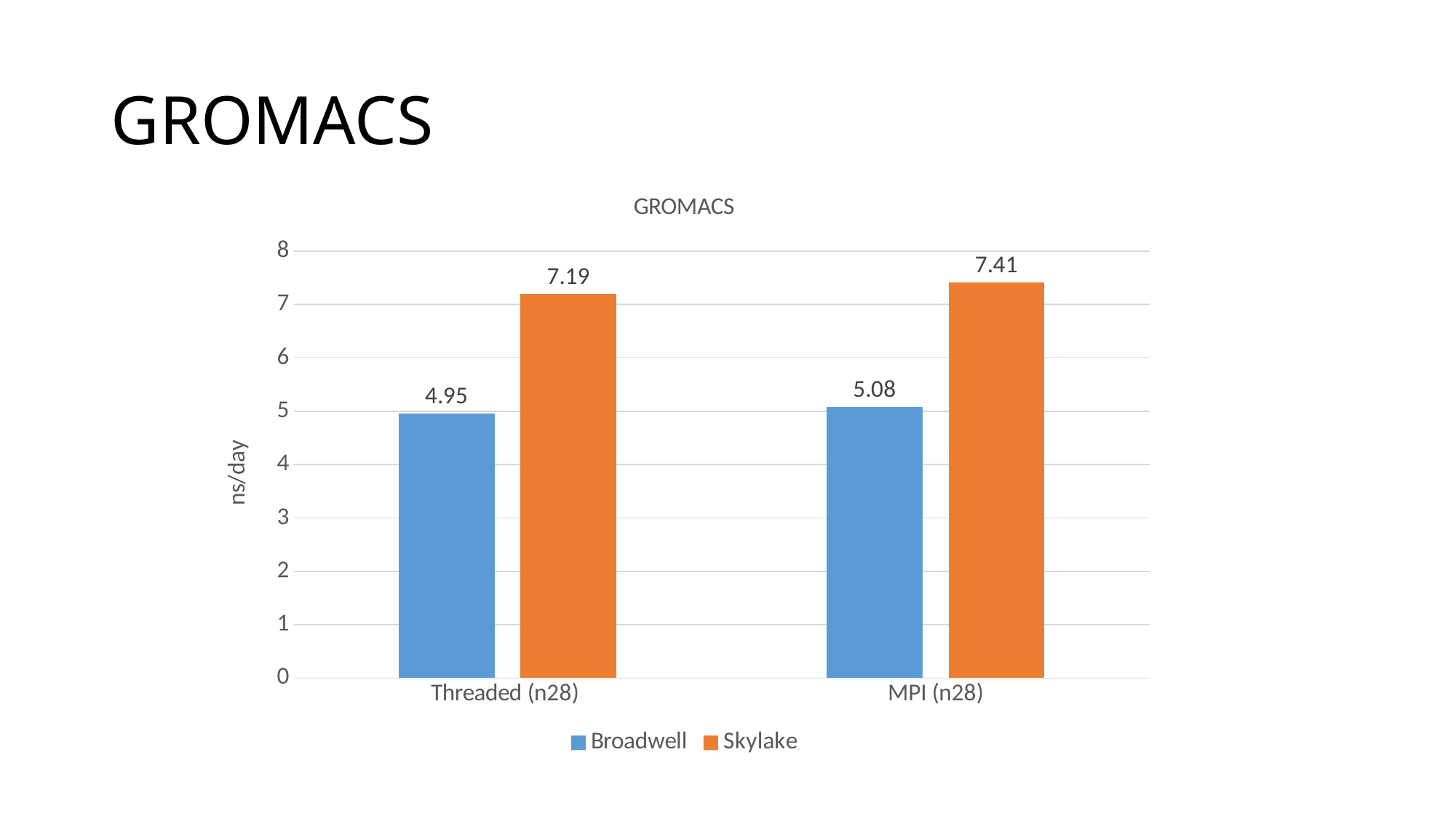
What is the Broadwell value for Threaded (n28)? 4.95 What is the difference between the Skylake and Broadwell values for MPI (n28)? 2.33 Which bar has the highest value on the chart? Skylake, MPI (n28) Which is larger for Threaded (n28): Broadwell or Skylake? Skylake How many categories are shown on the x axis? 2 Which bar has the lowest value on the chart? Broadwell, Threaded (n28) What is the difference between the Skylake values for MPI (n28) and Threaded (n28)? 0.22 What is the Skylake value for Threaded (n28)? 7.19 What is the Broadwell value for MPI (n28)? 5.08 What is the label on the vertical axis? ns/day What is the Skylake value for MPI (n28)? 7.41 How many series does the legend list? 2